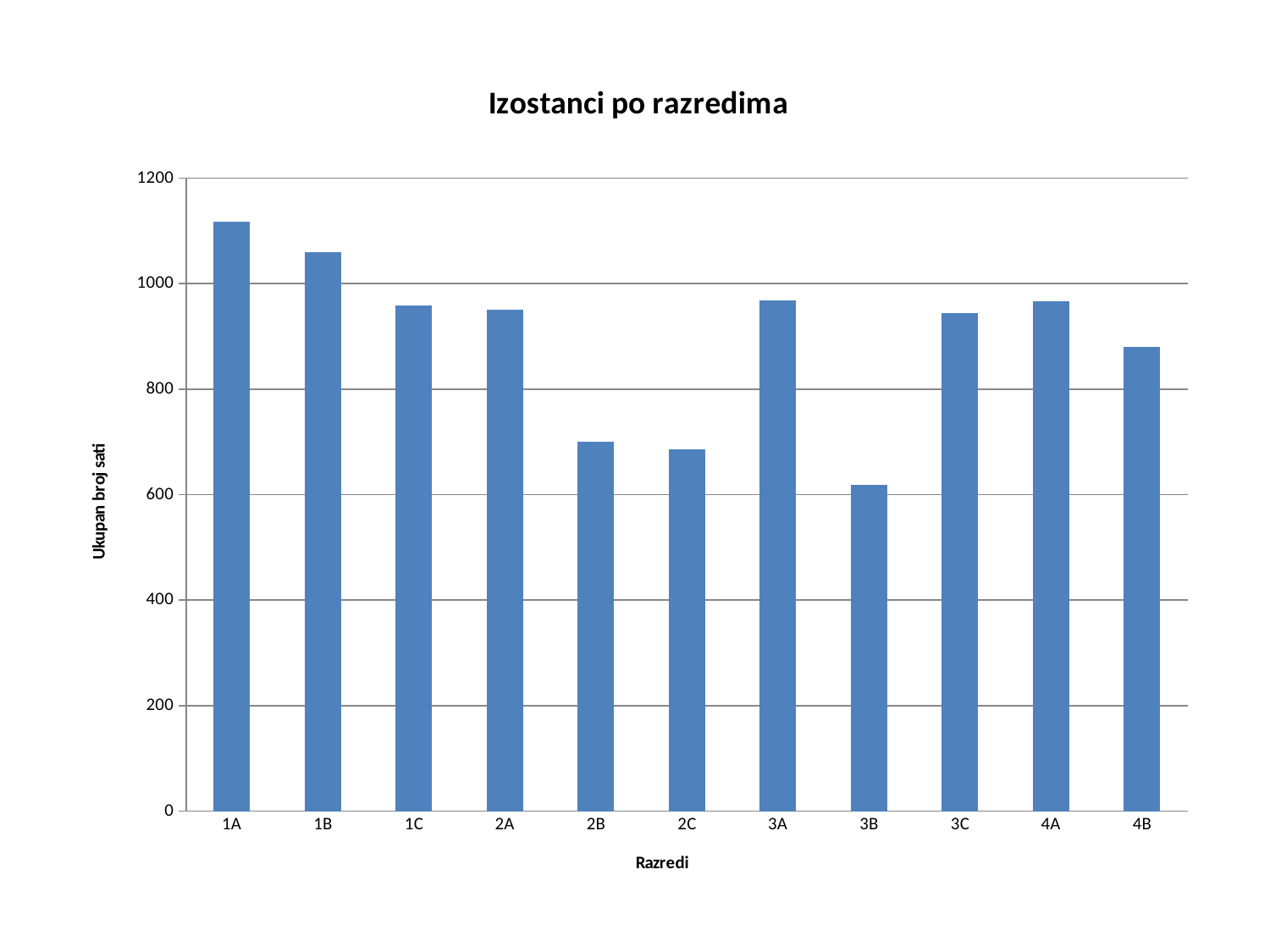
Which class has the highest total number of hours? 1A Is the value for 2C greater or less than 600? greater What is the title of the chart? Izostanci po razredima Which is larger, the value for 3C or the value for 4B? 3C Is the value for 4B greater or less than 800? greater How many classes (categories) are shown on the x axis? 11 Is the value for 2B greater or less than 800? less What kind of chart is shown on the slide? bar chart Which class has the lowest total number of hours? 3B What is the label of the vertical axis? Ukupan broj sati Which is larger, the value for 2B or the value for 3B? 2B